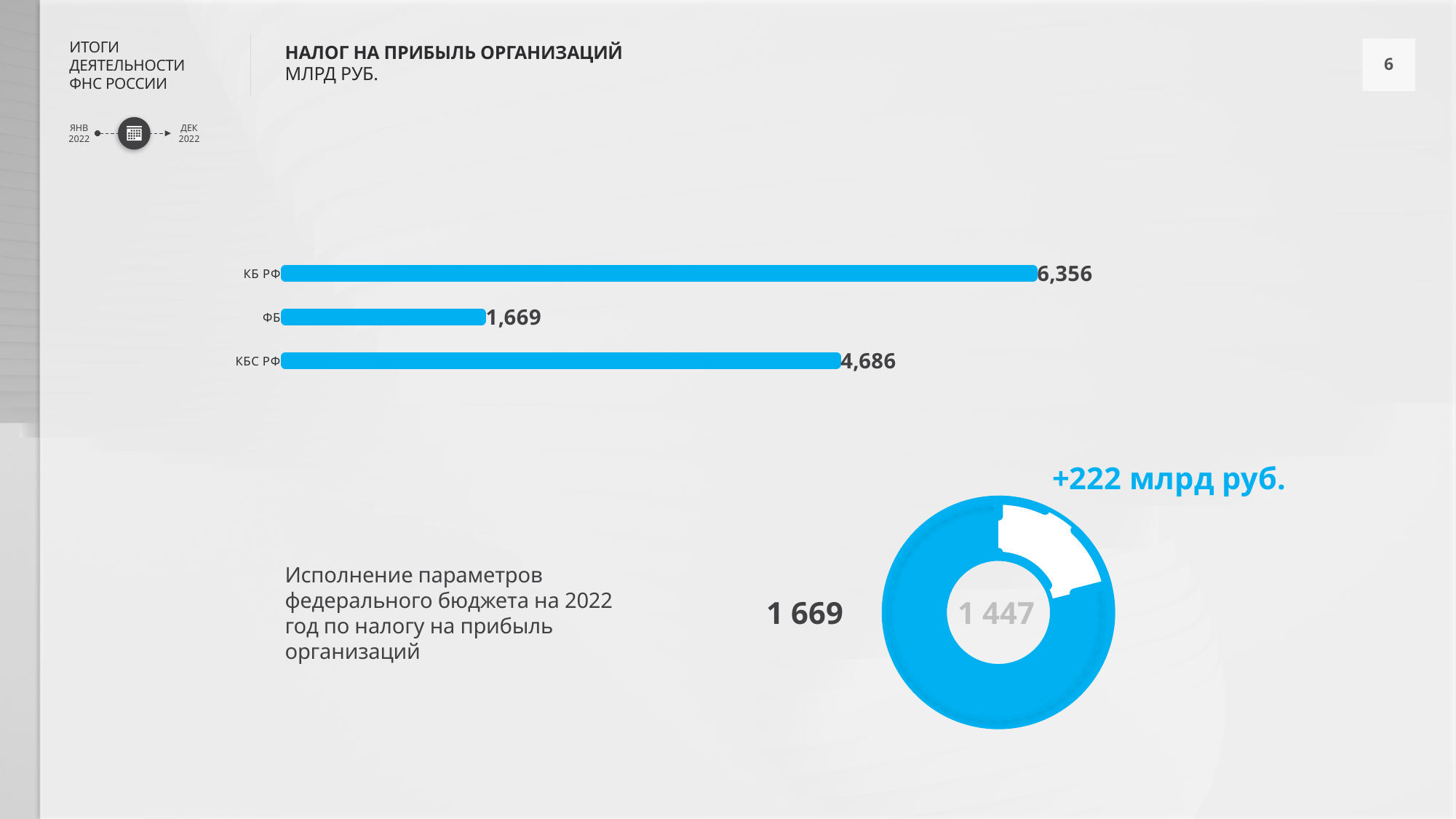
How many categories does the bar chart show? 3 What kind of chart is the chart at the bottom right of the slide? Donut chart In the bar chart, what is the value for КБ РФ? 6,356 In the bar chart, what is the value for КБС РФ? 4,686 In the bar chart, what is the difference between the values for КБ РФ and КБС РФ? 1,670 In the donut chart at the bottom right, what value is printed in the centre of the ring? 1 447 In the bar chart, what is the value for ФБ? 1,669 In the bar chart, which is larger, the value for КБС РФ or the value for ФБ? КБС РФ In the bar chart, which category has the highest value? КБ РФ In the bar chart, what is the difference between the values for КБС РФ and ФБ? 3,017 In the bar chart, which category has the lowest value? ФБ What kind of chart is the chart at the top of the slide? Bar chart